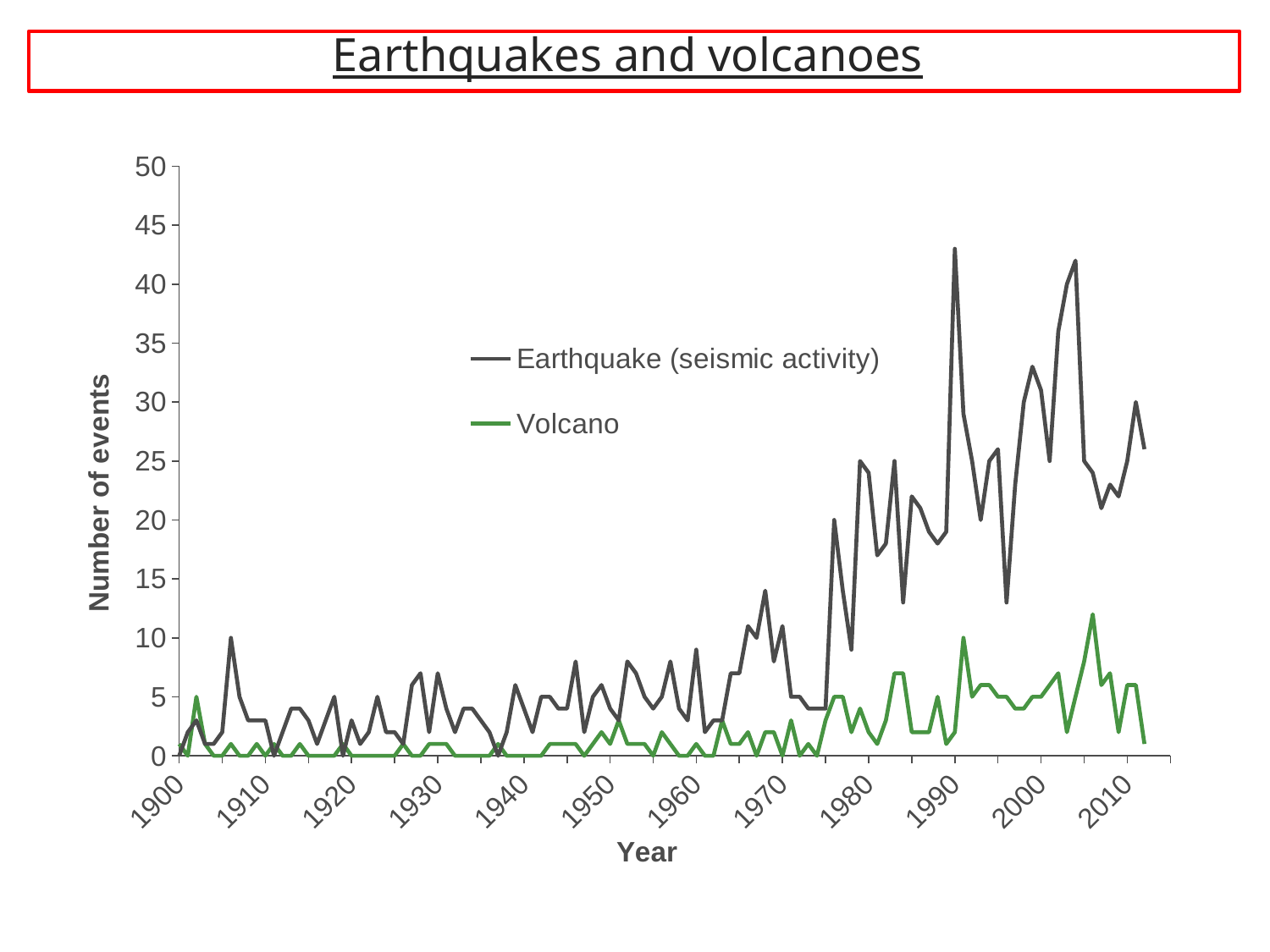
What is the label of the vertical axis? Number of events Overall, does the Earthquake (seismic activity) line rise or fall from 1900 to 2010? rise Is the highest value reached by the Earthquake (seismic activity) line greater or less than 40? greater Is the Earthquake (seismic activity) value in 1900 greater or less than 5? less In 2010, which series has the higher value, Earthquake (seismic activity) or Volcano? Earthquake (seismic activity) What kind of chart is shown on the slide? Line chart Is the highest value reached by the Volcano line greater or less than 15? less What are the two series named in the legend? Earthquake (seismic activity) and Volcano How many series does the legend list? 2 Which series reaches the higher peak value over the whole period? Earthquake (seismic activity)